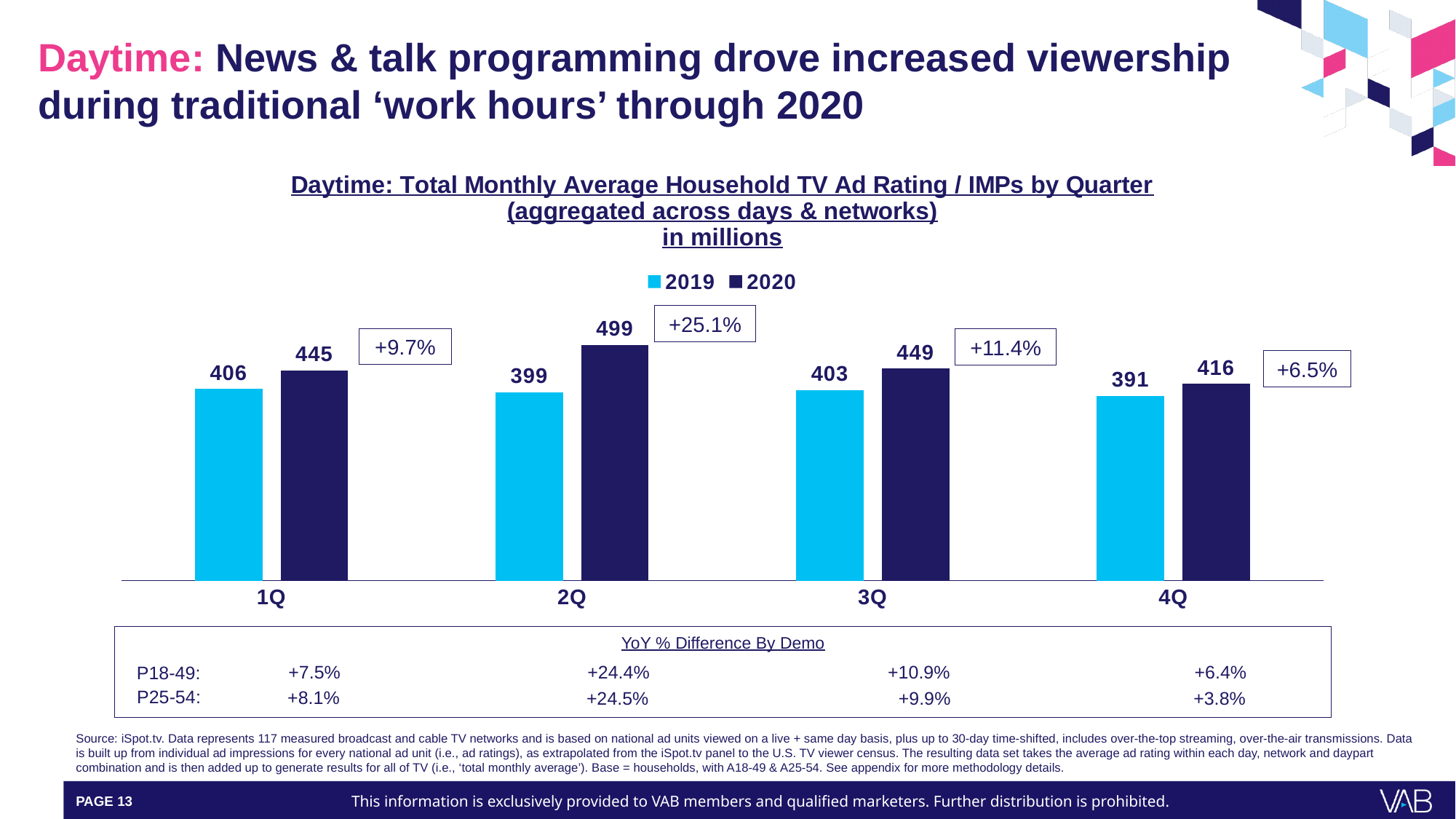
What kind of chart is shown on the slide? Bar chart What is the 2020 value for 2Q? 499 What year-over-year percentage change is shown for 3Q? +11.4% What is the 2019 value for 3Q? 403 Which quarter has the highest 2020 value? 2Q How many quarters are shown on the x axis? 4 How many series does the legend list? 2 Which is larger, the 2019 value for 1Q or the 2019 value for 2Q? 1Q What is the difference between the 2020 and 2019 values for 1Q? 39 What is the difference between the 2020 values for 2Q and 4Q? 83 Which quarter has the lowest 2019 value? 4Q What is the 2019 value for 4Q? 391